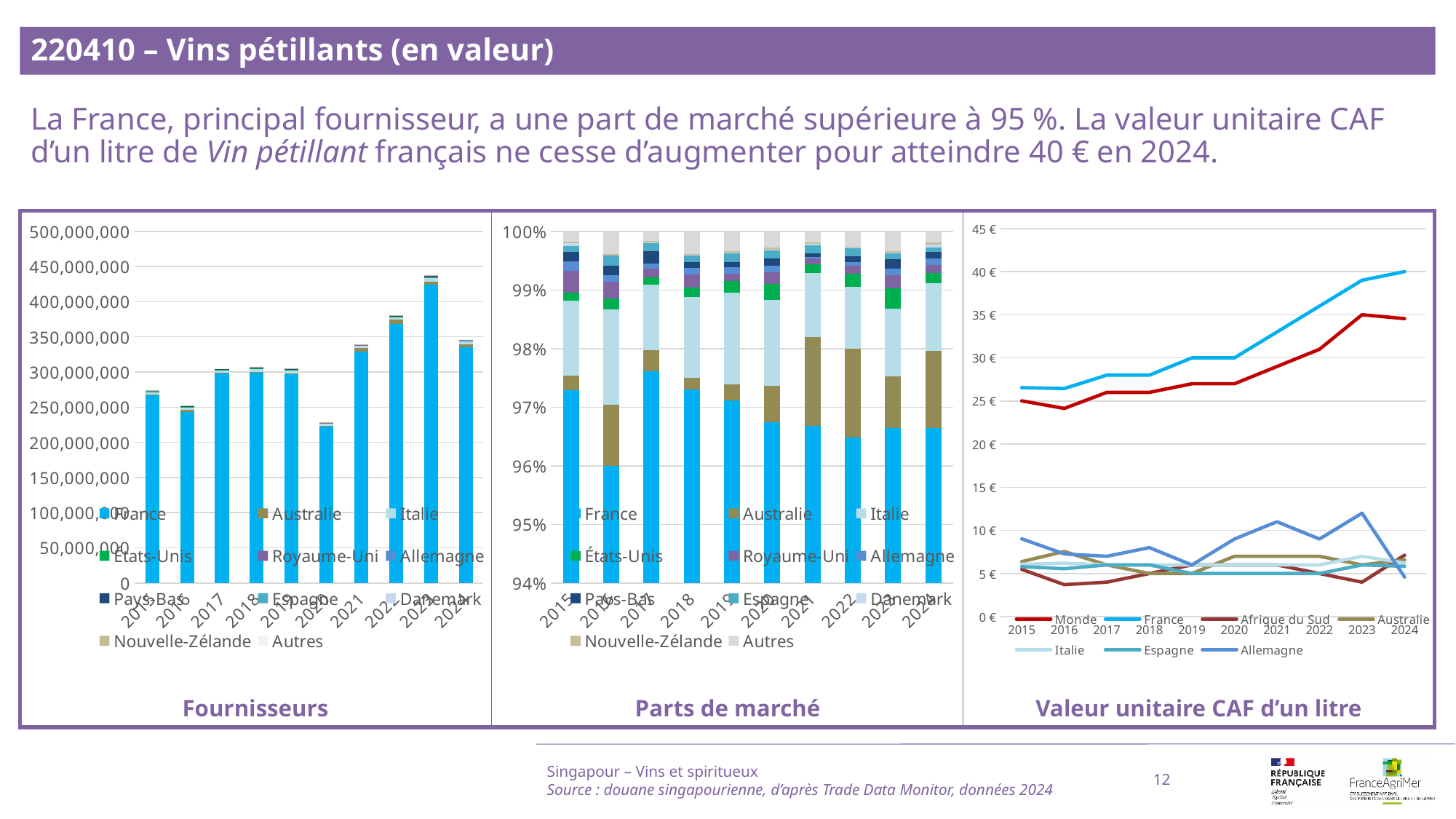
How many series does the legend of the 'Valeur unitaire CAF d'un litre' chart list? 7 In the 'Valeur unitaire CAF d'un litre' chart, what is the value for France in 2024? 40 € In the 'Valeur unitaire CAF d'un litre' chart, is the value for Monde in 2023 greater or less than 30 €? greater In the 'Fournisseurs' chart, which year has the highest total bar? 2023 In the 'Fournisseurs' chart, how many years are shown on the x axis? 10 What kind of chart is the 'Valeur unitaire CAF d'un litre' chart? line chart What kind of chart is the 'Fournisseurs' chart? bar chart In the 'Fournisseurs' chart, is the total for 2023 greater or less than 400,000,000? greater In the 'Fournisseurs' chart, is the total for 2020 greater or less than 250,000,000? less In the 'Valeur unitaire CAF d'un litre' chart, does the France line rise or fall from 2015 to 2024? rise In the 'Fournisseurs' chart, which year has the lowest total bar? 2020 How many series does the legend of the 'Fournisseurs' chart list? 11